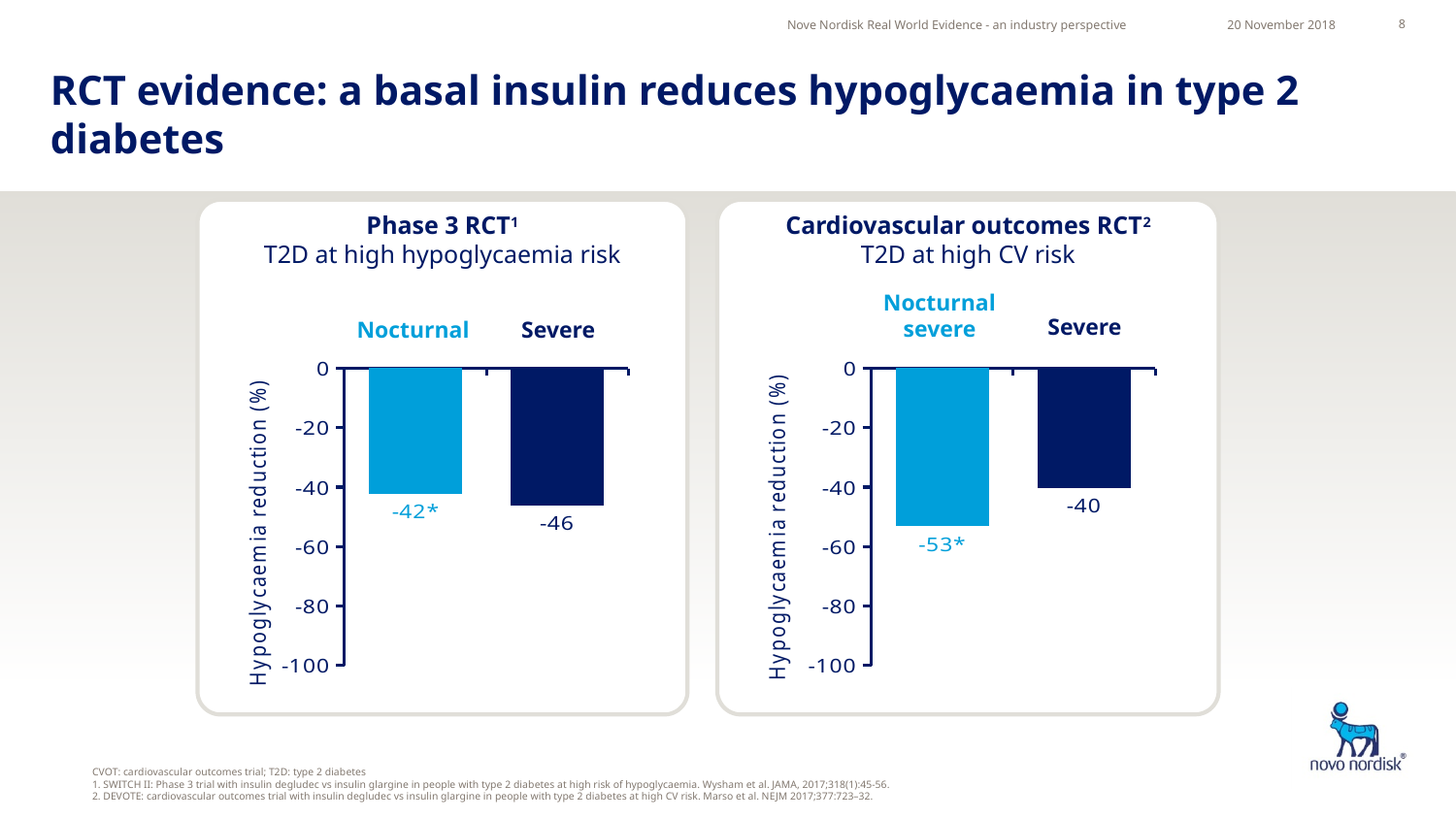
In the Cardiovascular outcomes RCT chart, what is the value for Severe? -40 What type of chart is the Cardiovascular outcomes RCT chart? Bar chart In the Cardiovascular outcomes RCT chart, which bar shows the larger hypoglycaemia reduction, Nocturnal severe or Severe? Nocturnal severe In the Cardiovascular outcomes RCT chart, which category has the lowest value? Nocturnal severe In the Cardiovascular outcomes RCT chart, what is the value for Nocturnal severe? -53* In the Cardiovascular outcomes RCT chart, what is the difference between the Nocturnal severe and Severe values? 13 How many categories are plotted in the Phase 3 RCT chart? 2 In the Phase 3 RCT chart, what is the value for Severe? -46 In the Phase 3 RCT chart, what is the difference between the Nocturnal and Severe values? 4 In the Phase 3 RCT chart, which category has the lowest value? Severe What is the y-axis label of the Phase 3 RCT chart? Hypoglycaemia reduction (%) In the Phase 3 RCT chart, what is the value for Nocturnal? -42*